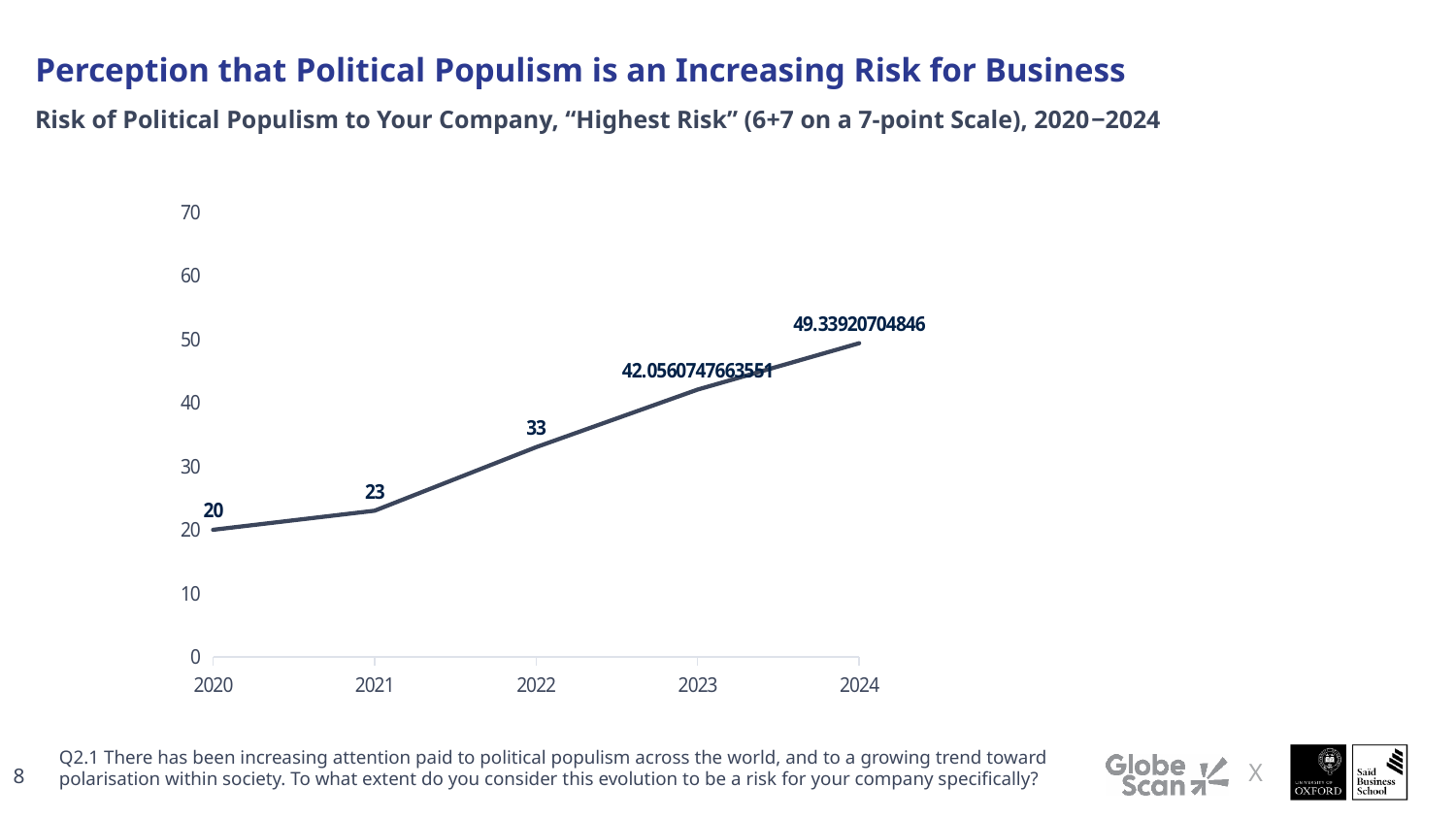
What is the value for 2022? 33 How many years are plotted on the x axis? 5 What is the difference between the values for 2022 and 2021? 10 Which year has the highest value? 2024 What is the data label shown for 2024? 49.33920704846 What is the value for 2020? 20 Is the value for 2023 greater or less than 40? greater Which year has the lowest value? 2020 What is the data label shown for 2023? 42.0560747663551 What is the value for 2021? 23 Which is larger, the value for 2021 or the value for 2022? 2022 What kind of chart is shown on the slide? Line chart